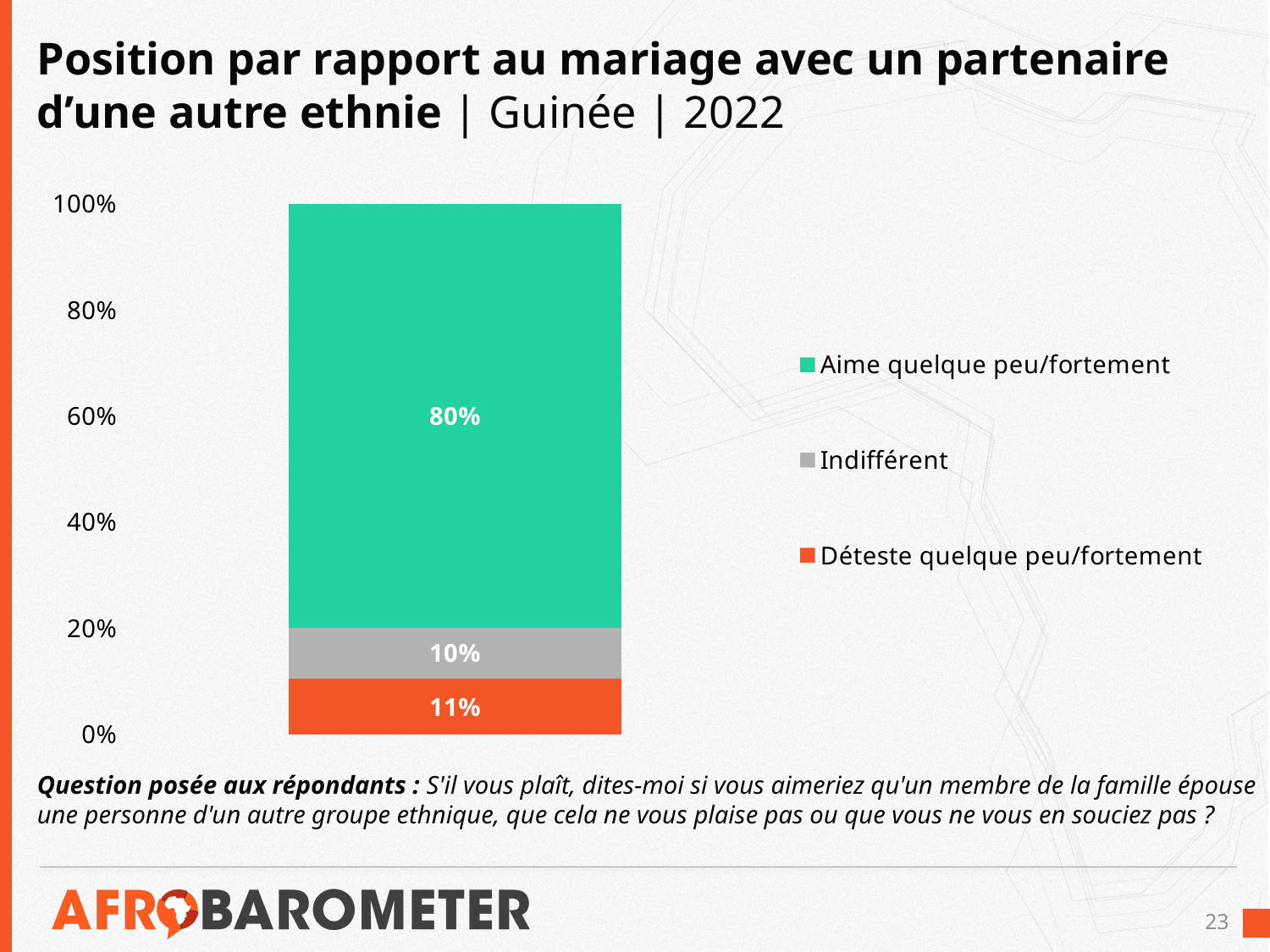
What percentage of respondents are 'Indifférent'? 10% What percentage of respondents are in the 'Déteste quelque peu/fortement' category? 11% How many series does the legend list? 3 What is the difference in percentage points between 'Aime quelque peu/fortement' and 'Déteste quelque peu/fortement'? 69 percentage points Which colour represents the 'Indifférent' category in the legend? Grey Which category has the largest share of respondents? Aime quelque peu/fortement What kind of chart is shown on the slide? Stacked bar chart What percentage of respondents are in the 'Aime quelque peu/fortement' category? 80% What is the total of the three segments in the stacked bar? 101% Is the value for 'Aime quelque peu/fortement' greater or less than 60%? greater Which category has the smallest share of respondents? Indifférent Which is larger: the share for 'Déteste quelque peu/fortement' or the share for 'Indifférent'? Déteste quelque peu/fortement